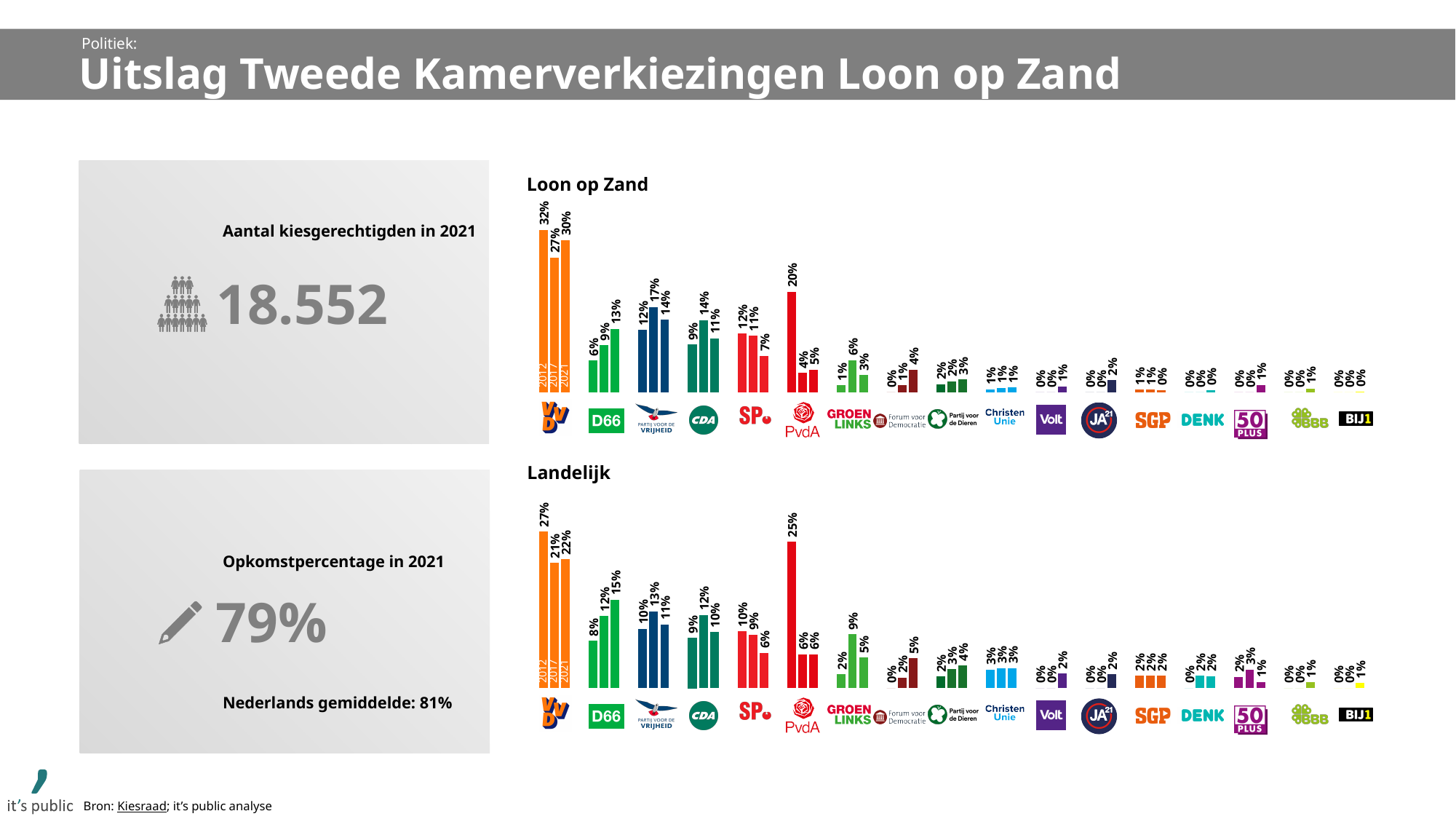
In the 'Landelijk' chart, what percentage did the PvdA get in 2012? 25% In the 'Loon op Zand' chart, what percentage did the PvdA get in 2012? 20% In the 'Loon op Zand' chart, what is the difference between the VVD's 2012 and 2017 percentages? 5% In the 'Landelijk' chart, what percentage did D66 get in 2021? 15% In the 'Loon op Zand' chart, what percentage did the VVD get in 2021? 30% In the 'Loon op Zand' chart, which party has the highest value in 2021? VVD In the 'Loon op Zand' chart, which is larger: the 2021 value for D66 or the 2021 value for the CDA? D66 In the 'Landelijk' chart, which is larger: the 2021 value for the VVD or the 2021 value for D66? VVD In the 'Landelijk' chart, do D66's values rise or fall from 2012 to 2021? rise What kind of chart is the 'Landelijk' chart? bar chart In the 'Loon op Zand' chart, do the SP's values rise or fall from 2012 to 2021? fall In the 'Landelijk' chart, what is the difference between the PvdA's 2012 and 2017 percentages? 19%